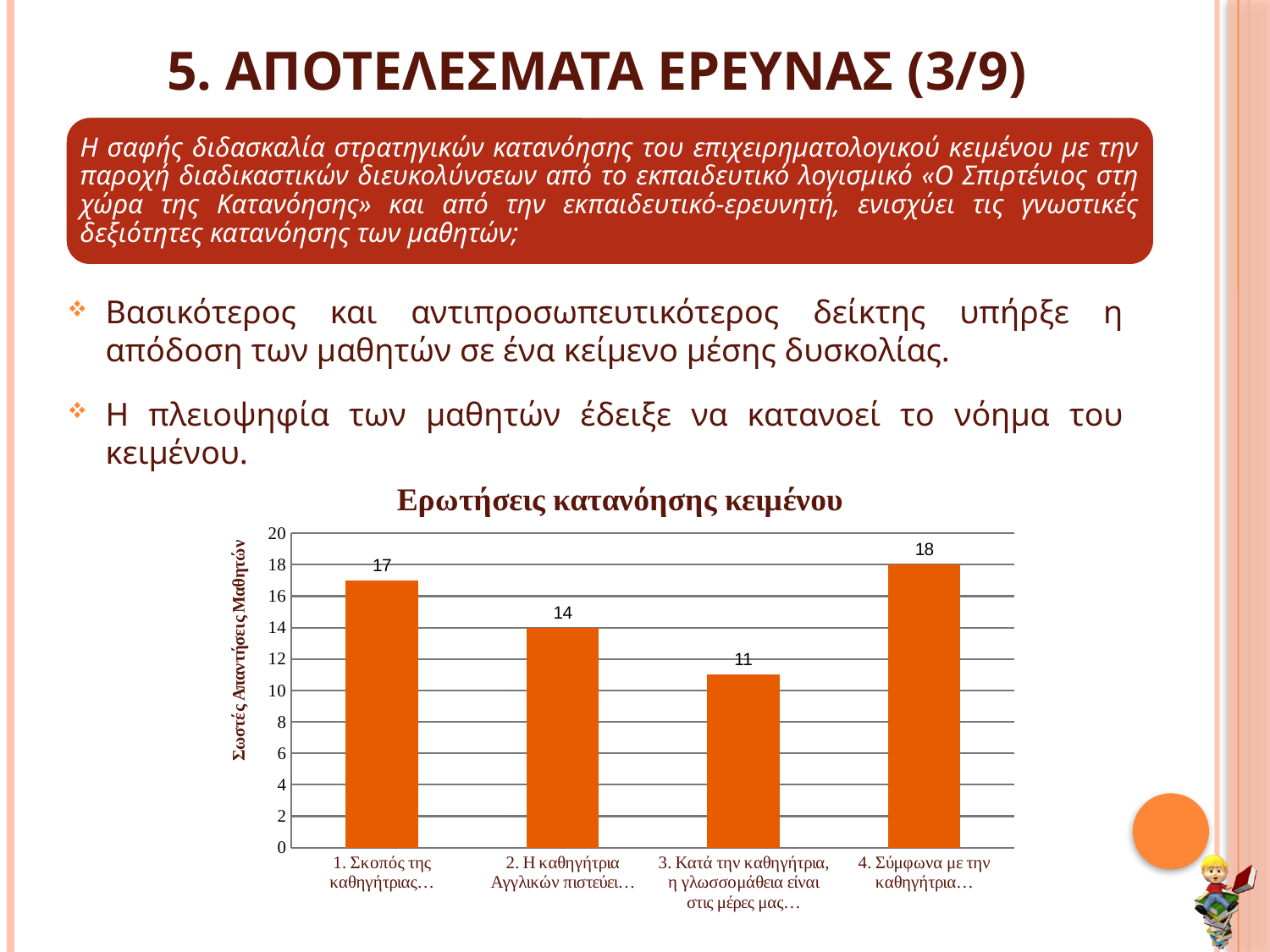
Which is larger, the value for category 1 or the value for category 2? 1. Σκοπός της καθηγήτριας… What is the value for "2. Η καθηγήτρια Αγγλικών πιστεύει…"? 14 What kind of chart is shown on the slide? bar chart What is the difference between the values for category 4 and category 3? 7 Which category has the highest value? 4. Σύμφωνα με την καθηγήτρια… What is the title of the chart? Ερωτήσεις κατανόησης κειμένου What is the value for "1. Σκοπός της καθηγήτριας…"? 17 Which category has the lowest value? 3. Κατά την καθηγήτρια, η γλωσσομάθεια είναι στις μέρες μας… How many categories are shown on the x axis? 4 Is the value for category 2 greater or less than 12? greater What is the value for "4. Σύμφωνα με την καθηγήτρια…"? 18 What is the value for "3. Κατά την καθηγήτρια, η γλωσσομάθεια είναι στις μέρες μας…"? 11